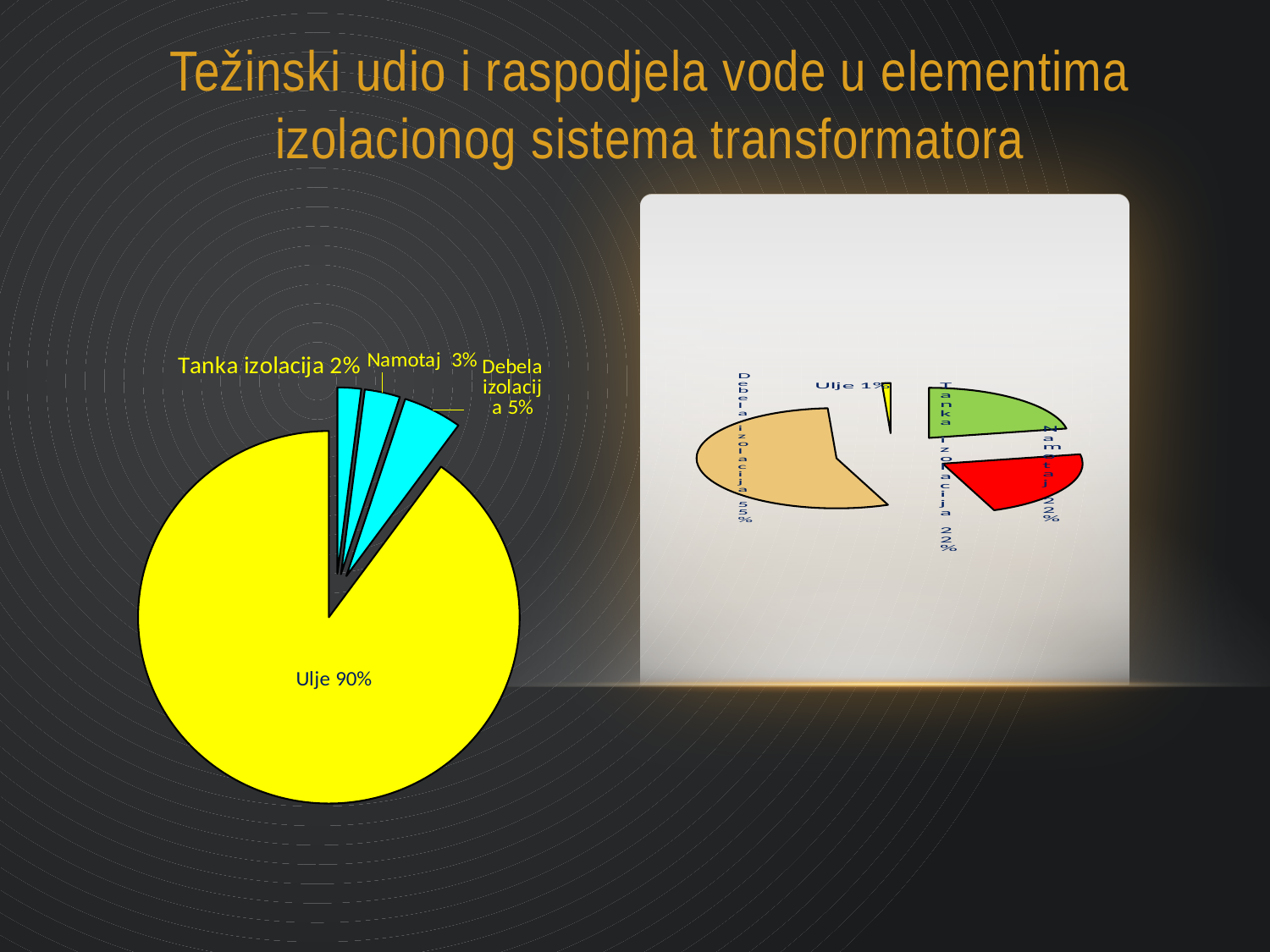
In the right pie chart, what share does Debela izolacija have? 55% In the left pie chart, which category has the largest slice? Ulje In the left pie chart, which category has the smallest slice? Tanka izolacija In the left pie chart, what is the difference between the shares of Debela izolacija and Namotaj? 2% In the right pie chart, which category has the largest slice? Debela izolacija In the right pie chart, what share does Ulje have? 1% What type of chart is the left chart? Pie chart In the left pie chart, what share does Ulje have? 90% In the left pie chart, how many slices are there? 4 In the left pie chart, what share does Debela izolacija have? 5% In the left pie chart, what share does Namotaj have? 3% In the left pie chart, what share does Tanka izolacija have? 2%